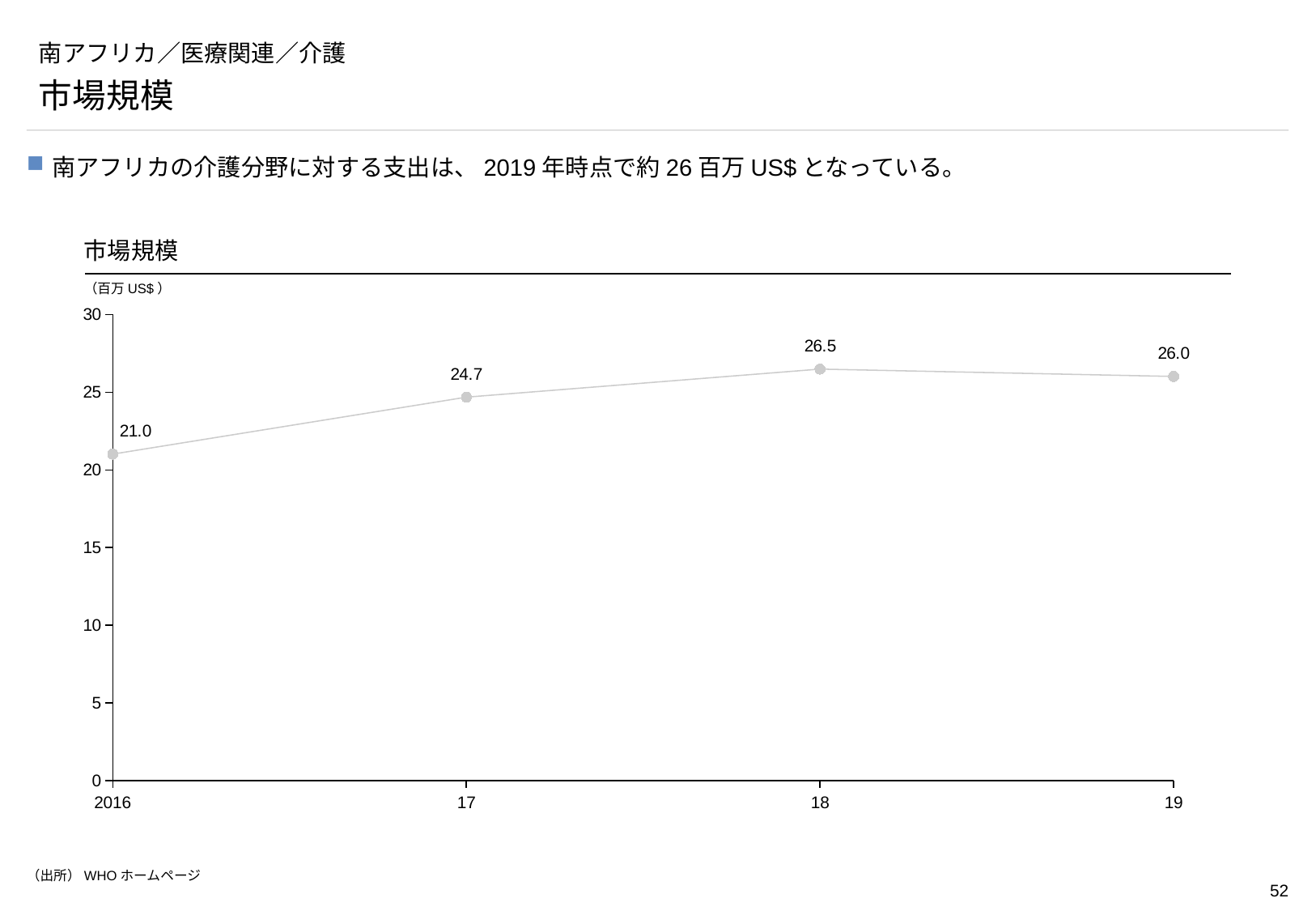
What is the market size value for 2018? 26.5 Which year has the highest market size? 2018 What unit is shown for the chart's values? 百万 US$ Which is larger, the market size in 2017 or in 2019? 2019 Is the value for 2016 greater or less than 20? greater What is the market size value for 2017? 24.7 What is the difference between the market size in 2018 and in 2016? 5.5 What is the market size value for 2019? 26.0 What is the market size value for 2016? 21.0 Which year has the lowest market size? 2016 How many years are plotted on the chart? 4 What kind of chart is shown on the slide? line chart